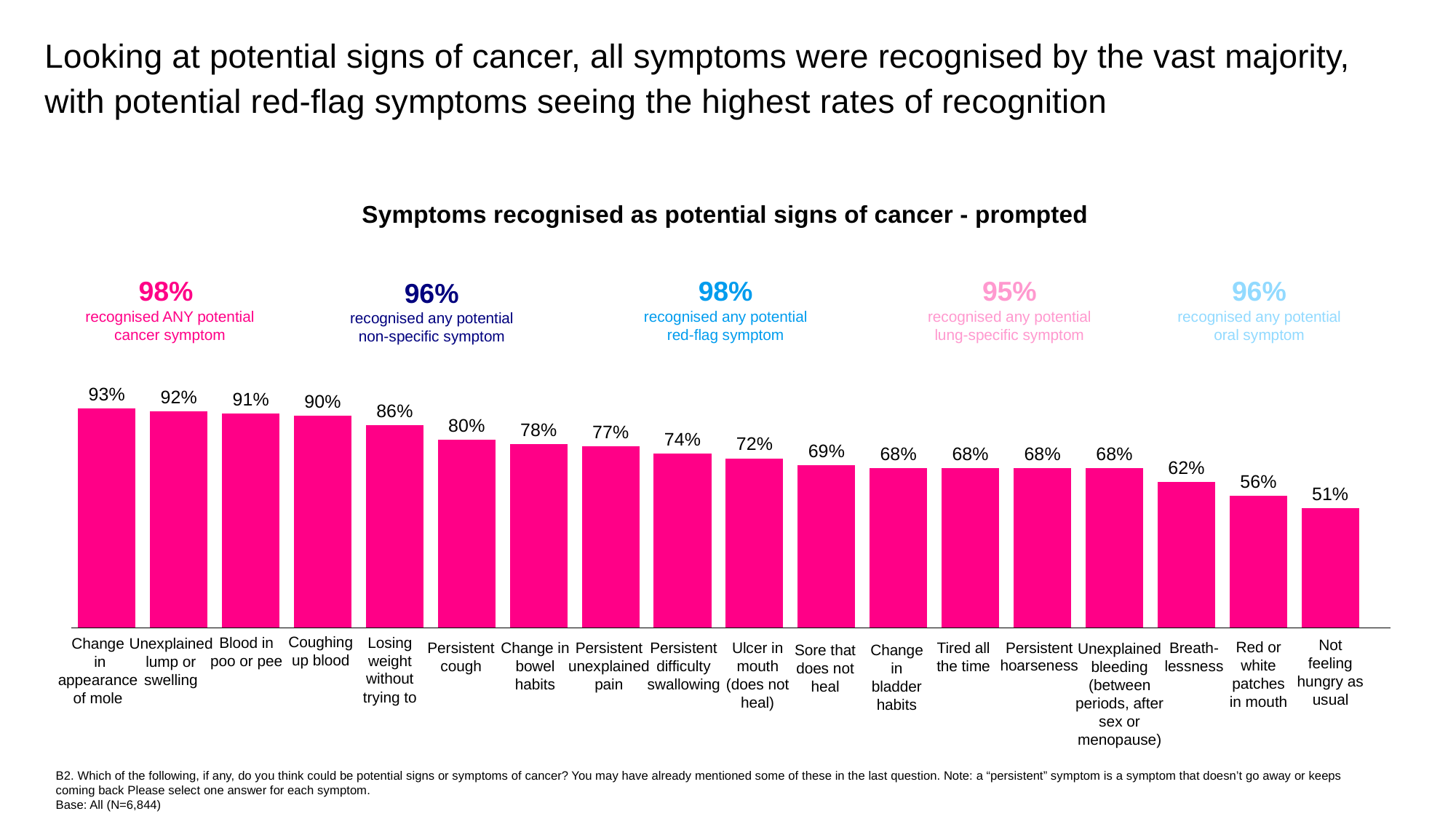
According to the summary figures above the chart, what percentage recognised any potential red-flag symptom? 98% Which has a higher value: 'Ulcer in mouth (does not heal)' or 'Red or white patches in mouth'? Ulcer in mouth (does not heal) What is the value for 'Persistent cough'? 80% Do the bar values rise or fall from left to right along the x axis? Fall Which symptom has the lowest recognition rate? Not feeling hungry as usual What kind of chart is shown on the slide? Bar chart What percentage recognised 'Not feeling hungry as usual' as a potential sign of cancer? 51% Which symptom has the highest recognition rate? Change in appearance of mole How many symptoms are plotted as bars in the chart? 18 What is the difference between the values for 'Coughing up blood' and 'Breathlessness'? 28% What is the title of the chart? Symptoms recognised as potential signs of cancer - prompted What percentage recognised 'Change in appearance of mole' as a potential sign of cancer? 93%